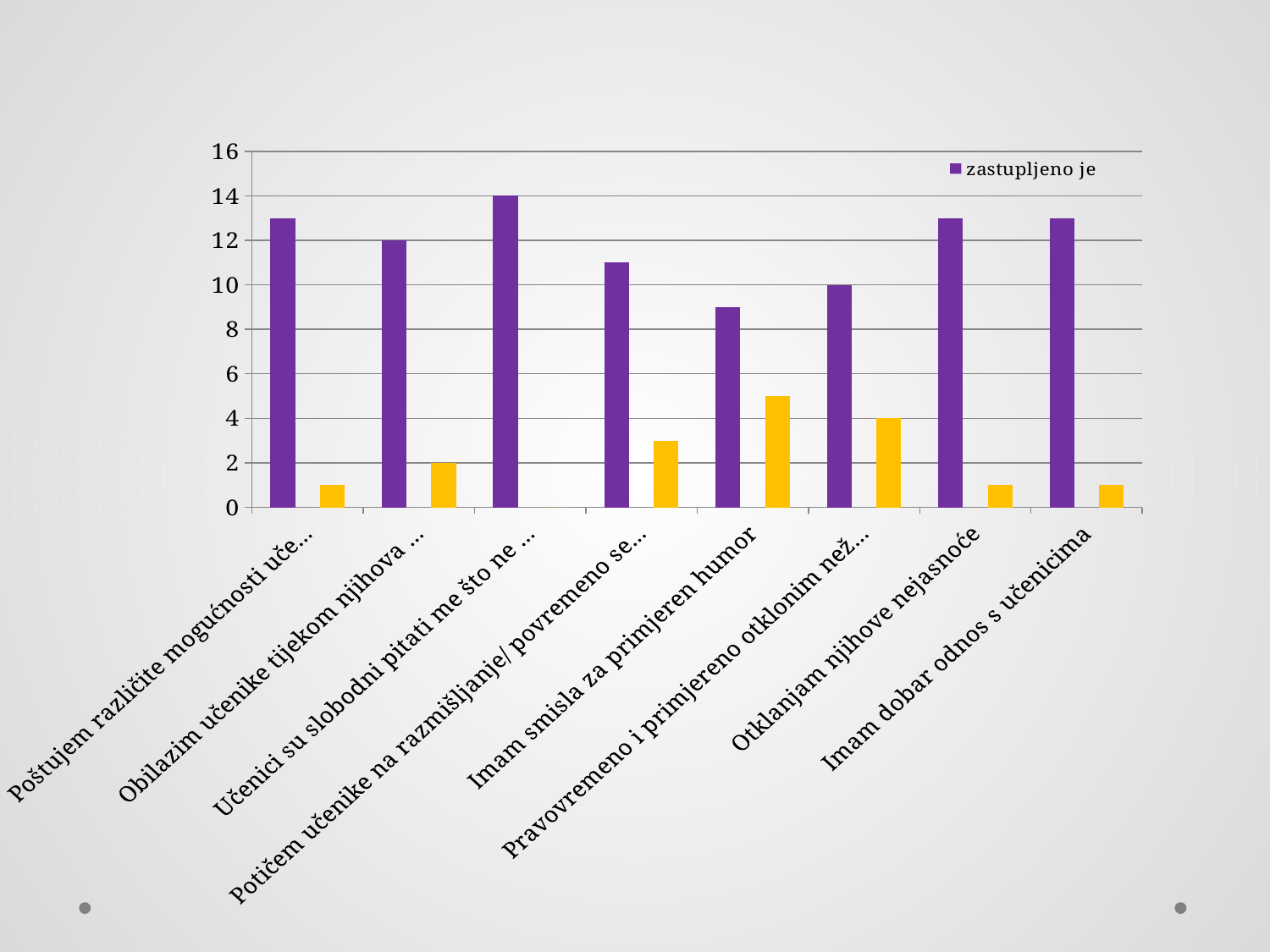
What kind of chart is shown on the slide? bar chart Which category has the highest purple 'zastupljeno je' bar? Učenici su slobodni pitati me što ne ... What is the difference between the purple 'zastupljeno je' values for 'Učenici su slobodni pitati me što ne ...' and 'Obilazim učenike tijekom njihova ...'? 2 Is the purple 'zastupljeno je' value for 'Imam smisla za primjeren humor' greater or less than 10? less What is the value of the purple 'zastupljeno je' bar for 'Obilazim učenike tijekom njihova ...'? 12 How many categories are shown along the x axis? 8 What is the value of the yellow bar for 'Pravovremeno i primjereno otklonim než...'? 4 Which category has the lowest purple 'zastupljeno je' bar? Imam smisla za primjeren humor What is the value of the purple 'zastupljeno je' bar for 'Učenici su slobodni pitati me što ne ...'? 14 What is the value of the purple 'zastupljeno je' bar for 'Pravovremeno i primjereno otklonim než...'? 10 How many series does the legend list? 1 What is the series name shown in the legend? zastupljeno je